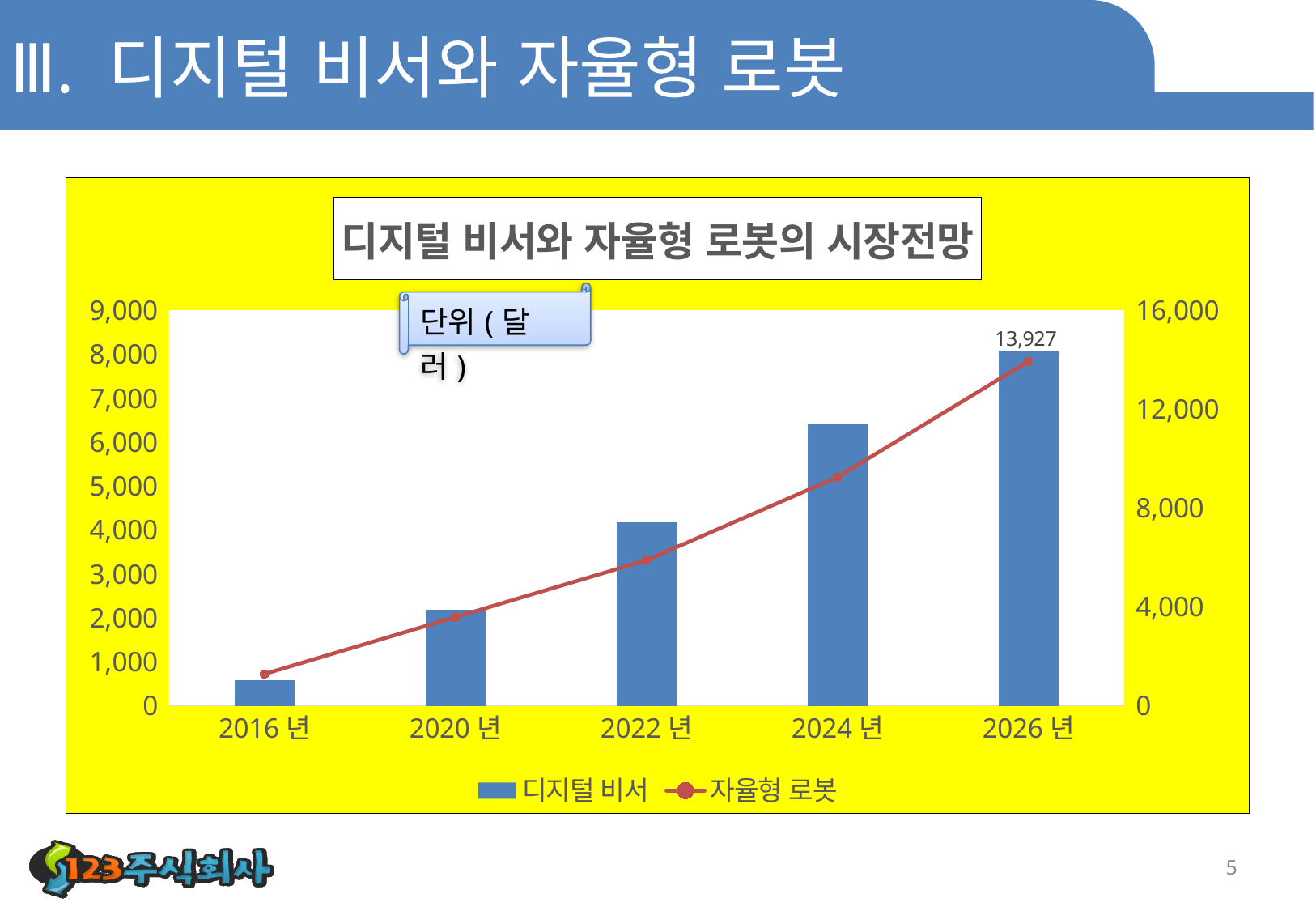
Which year has the highest 디지털 비서 bar? 2026 년 What kind of chart is this? Combined bar and line chart Do the 디지털 비서 values rise or fall from 2016 년 to 2026 년? Rise How many series does the chart legend list? 2 Is the 자율형 로봇 value for 2024 년 greater or less than 8,000 on the right axis? greater What is the value of 자율형 로봇 in 2026 년? 13,927 Is the 디지털 비서 value for 2016 년 greater or less than 1,000 on the left axis? less How many year categories are shown on the x axis? 5 Is the 디지털 비서 value for 2024 년 greater or less than 6,000 on the left axis? greater Which series is drawn as a red line with markers? 자율형 로봇 Which year has the lowest 디지털 비서 bar? 2016 년 What is the title of the chart? 디지털 비서와 자율형 로봇의 시장전망